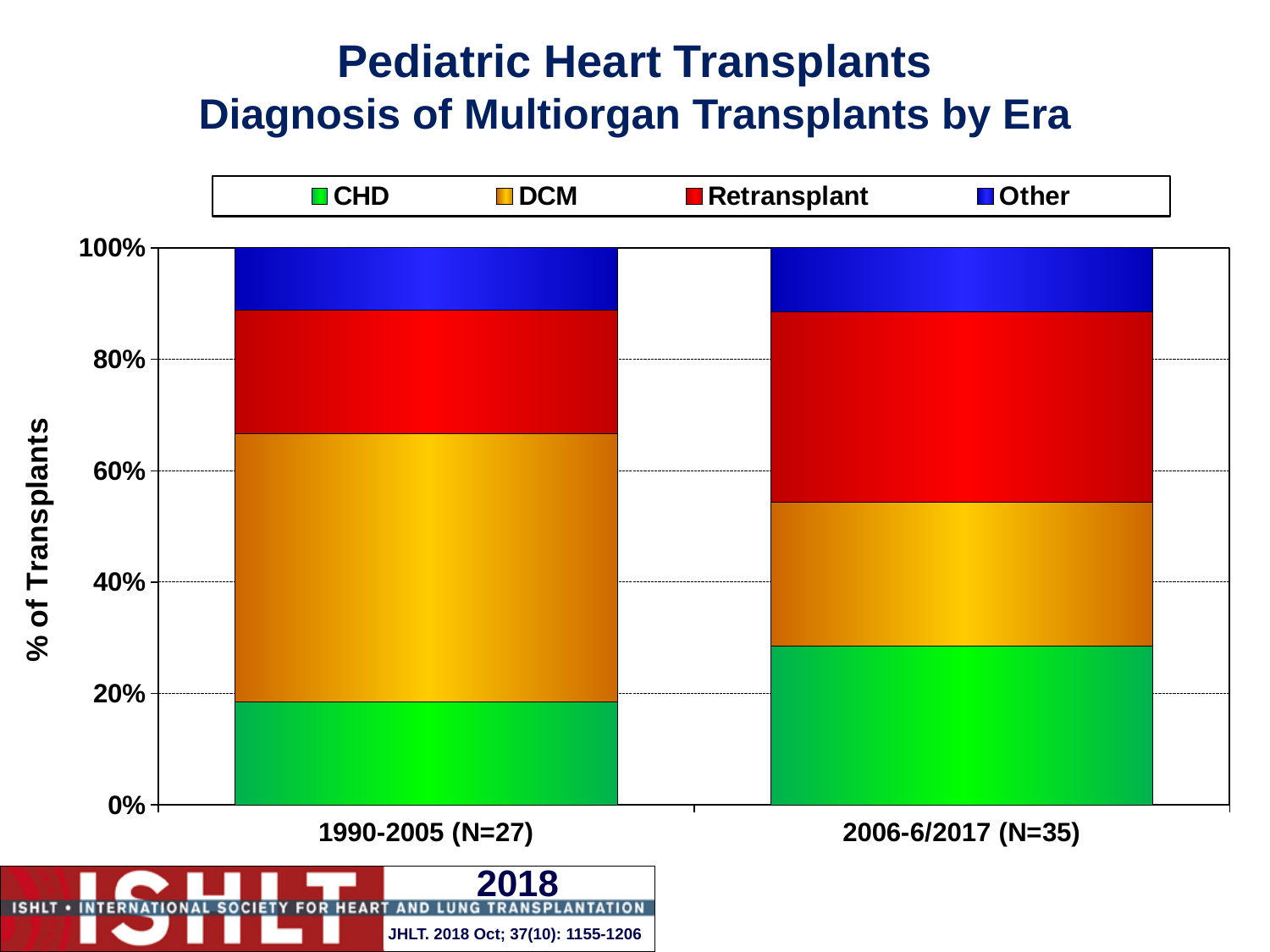
How many eras (bars) are shown on the x axis? 2 Is the DCM share larger in 1990-2005 or in 2006-6/2017? 1990-2005 Which diagnosis categories are listed in the legend? CHD, DCM, Retransplant, Other What kind of chart is shown on the slide? Stacked bar chart What is the total height of each stacked bar? 100% Is the CHD share larger in 1990-2005 or in 2006-6/2017? 2006-6/2017 How many series does the legend list? 4 Is the DCM share for 1990-2005 greater or less than 40%? greater What is the N for the 1990-2005 era? 27 What is the N for the 2006-6/2017 era? 35 Which diagnosis makes up the largest share of the 1990-2005 bar? DCM Which diagnosis makes up the smallest share of the 1990-2005 bar? Other